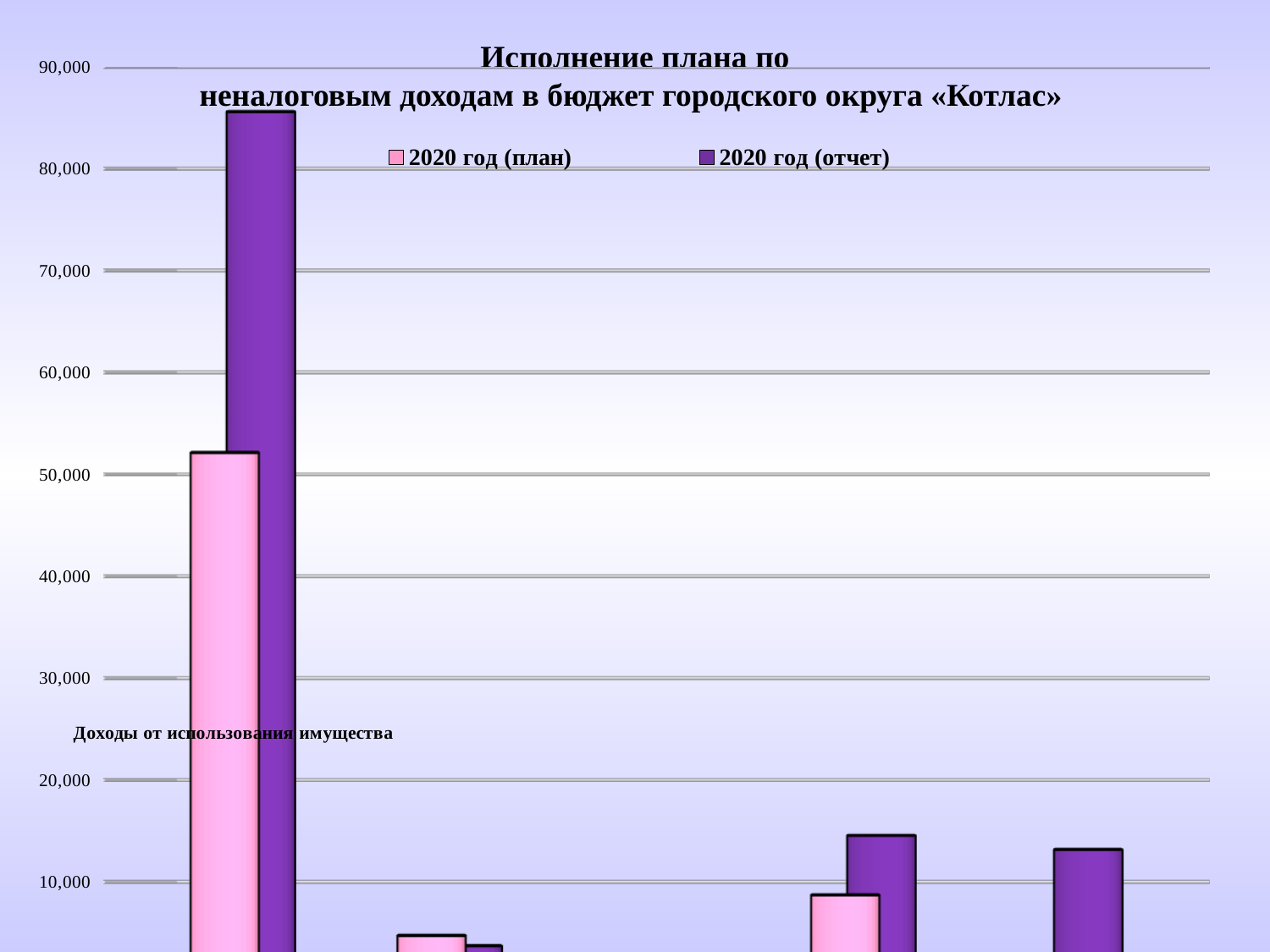
Which category has the highest 2020 год (план) value? Доходы от использования имущества Is the 2020 год (отчет) value for Доходы от использования имущества greater or less than 80,000? greater What kind of chart is shown on the slide? bar chart How many series does the legend list? 2 Is the 2020 год (план) value for Доходы от использования имущества greater or less than 60,000? less Is the 2020 год (план) value for Доходы от использования имущества greater or less than 50,000? greater Which colour represents the series 2020 год (отчет)? purple What are the two series named in the legend? 2020 год (план) and 2020 год (отчет) Which category has the highest 2020 год (отчет) value? Доходы от использования имущества For Доходы от использования имущества, which is larger: the 2020 год (план) value or the 2020 год (отчет) value? 2020 год (отчет)